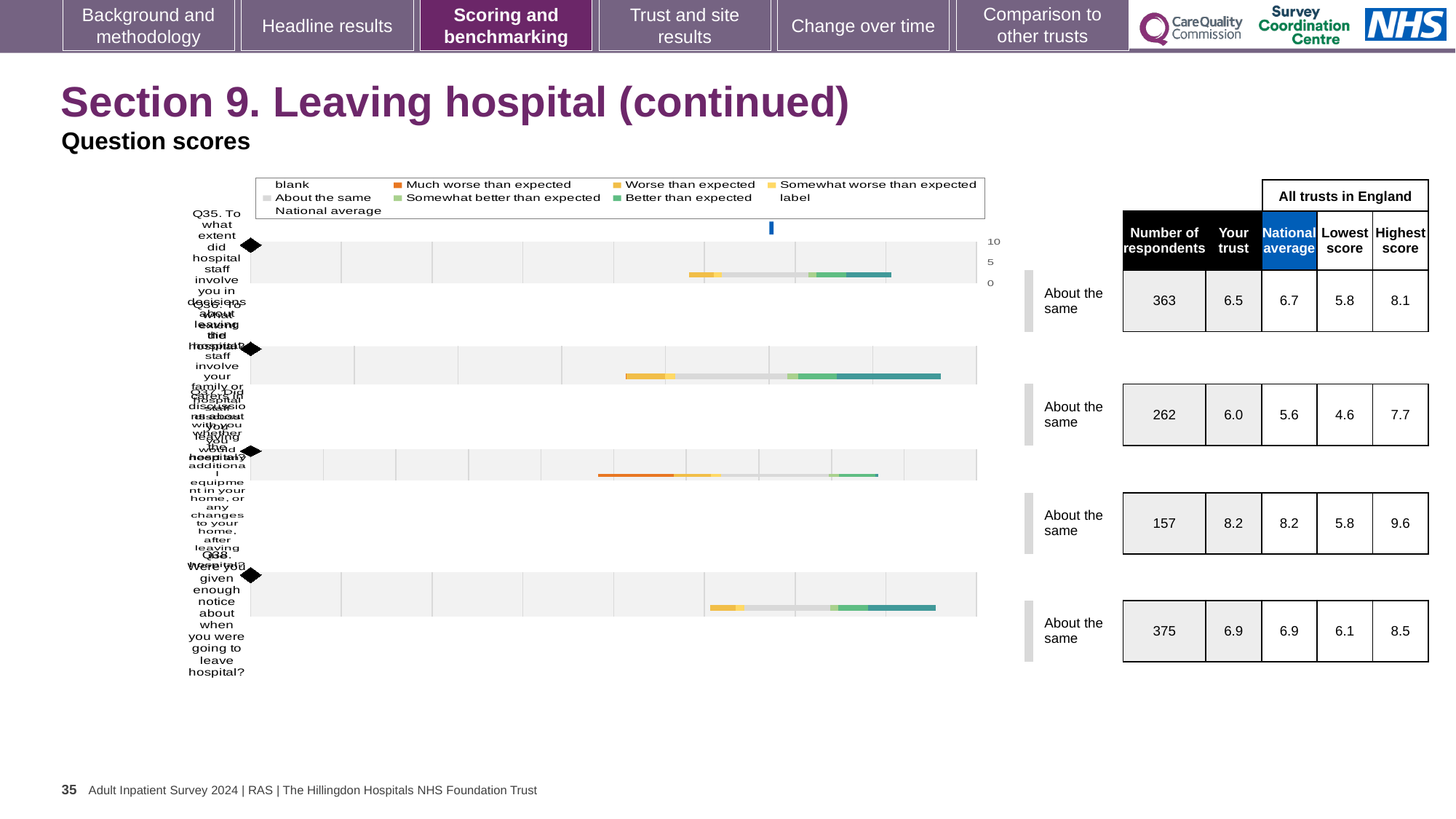
What is the 'Your trust' score for the last row (Q38)? 6.9 Which row has the lowest number of respondents? Q37 (third row), 157 How many entries does the chart legend list? 9 What kind of chart is used to show the question scores on this slide? bar chart What is the number of respondents for the first row (Q35)? 363 What colour does the legend use for 'Much worse than expected'? orange For the second row (Q36), which is larger: the 'Your trust' score or the national average? Your trust (6.0) For the first row (Q35), what is the difference between the highest score and the lowest score across all trusts in England? 2.3 What is the national average for the third row (Q37)? 8.2 Which row has the highest 'Your trust' score? Q37 (third row), 8.2 What benchmark category is shown for every question row on this slide? About the same How many question rows are plotted in the chart? 4